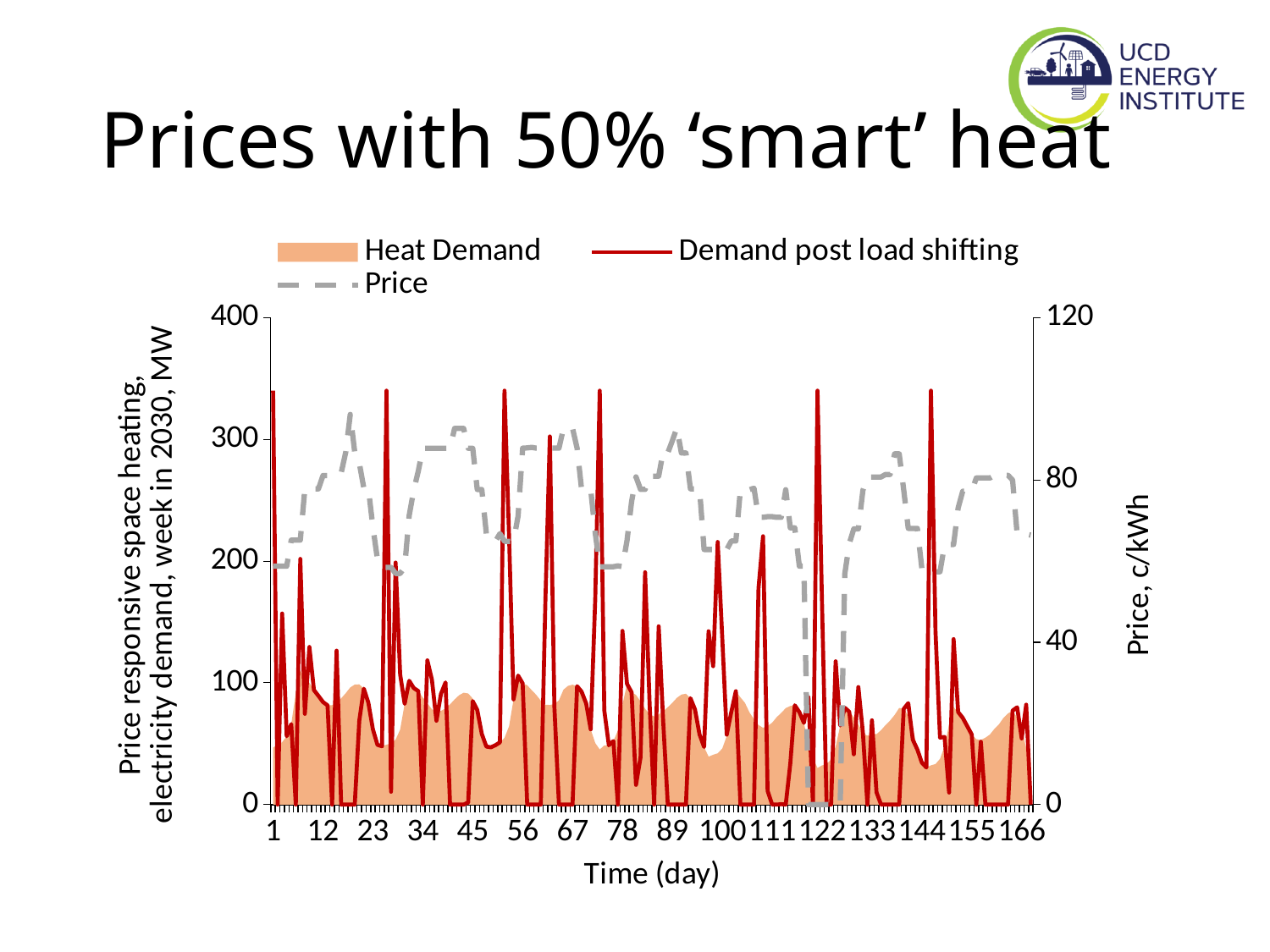
What is the label of the x axis? Time (day) What kind of chart is shown on the slide? line chart with a shaded area series Is the highest peak of the Demand post load shifting series greater or less than 300 MW? greater What is the title of the slide's chart? Prices with 50% 'smart' heat Is the Price at day 1 greater or less than 40 c/kWh? greater Which series in the legend is drawn as a dashed line? Price How many series does the chart legend list? 3 What is the highest value shown on the left-hand y axis? 400 What is the label of the right-hand y axis? Price, c/kWh What is the last day labelled on the x axis? 166 Is the Heat Demand series ever greater or less than 200 MW across the whole period? less What is the highest value shown on the right-hand y axis? 120